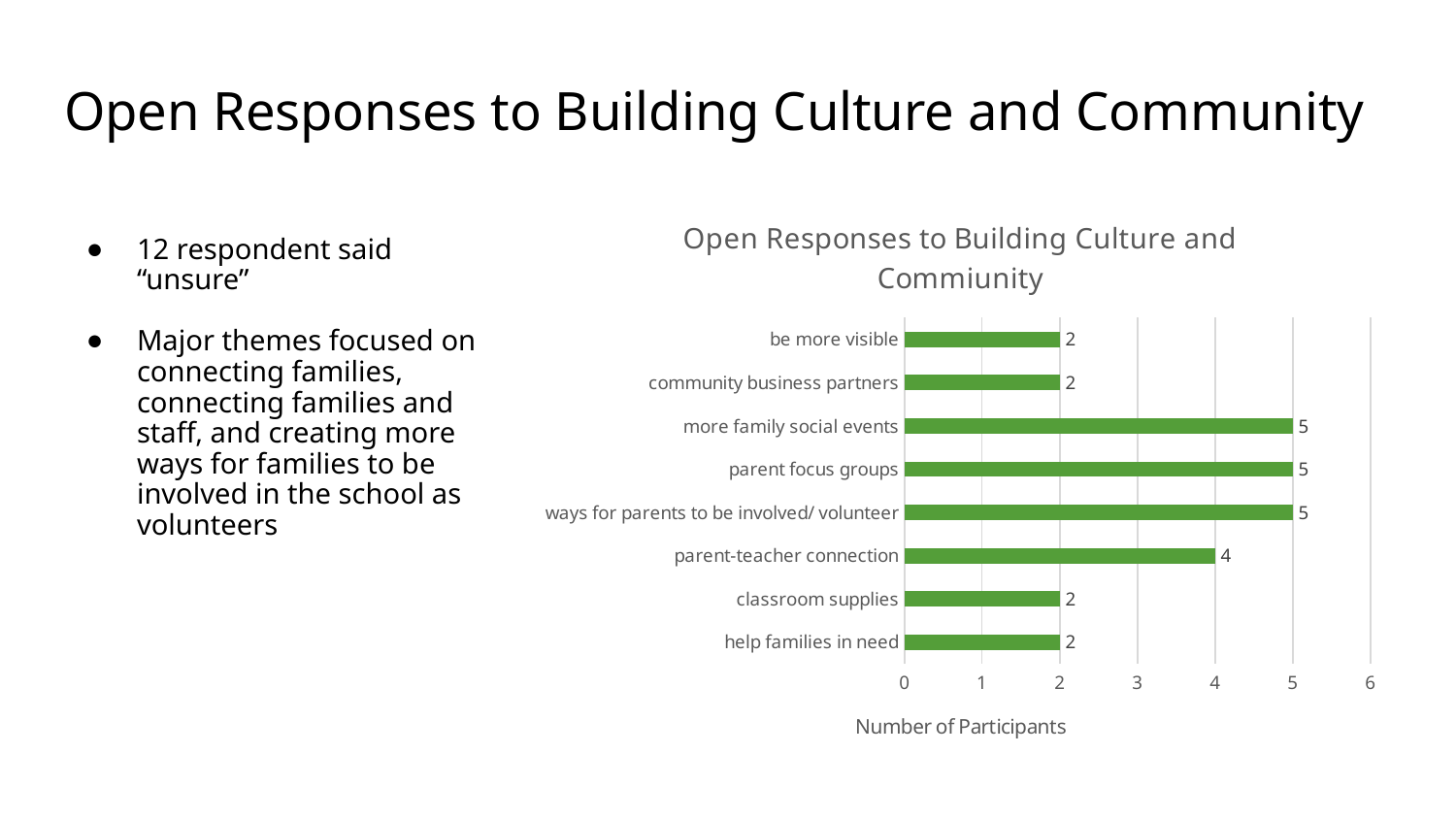
What is the value for "be more visible"? 2 How many categories are shown in the chart? 8 Which is larger, the value for "parent-teacher connection" or the value for "community business partners"? parent-teacher connection What is the label of the horizontal axis? Number of Participants What is the value for "parent-teacher connection"? 4 What is the title of the chart? Open Responses to Building Culture and Commiunity What is the difference between the values for "parent focus groups" and "parent-teacher connection"? 1 Which category has the lowest value that is not tied with another category? If none, which categories share the lowest value? be more visible, community business partners, classroom supplies, help families in need What kind of chart is shown on the slide? bar chart What is the value for "help families in need"? 2 What is the value for "more family social events"? 5 What is the difference between the values for "ways for parents to be involved/ volunteer" and "classroom supplies"? 3